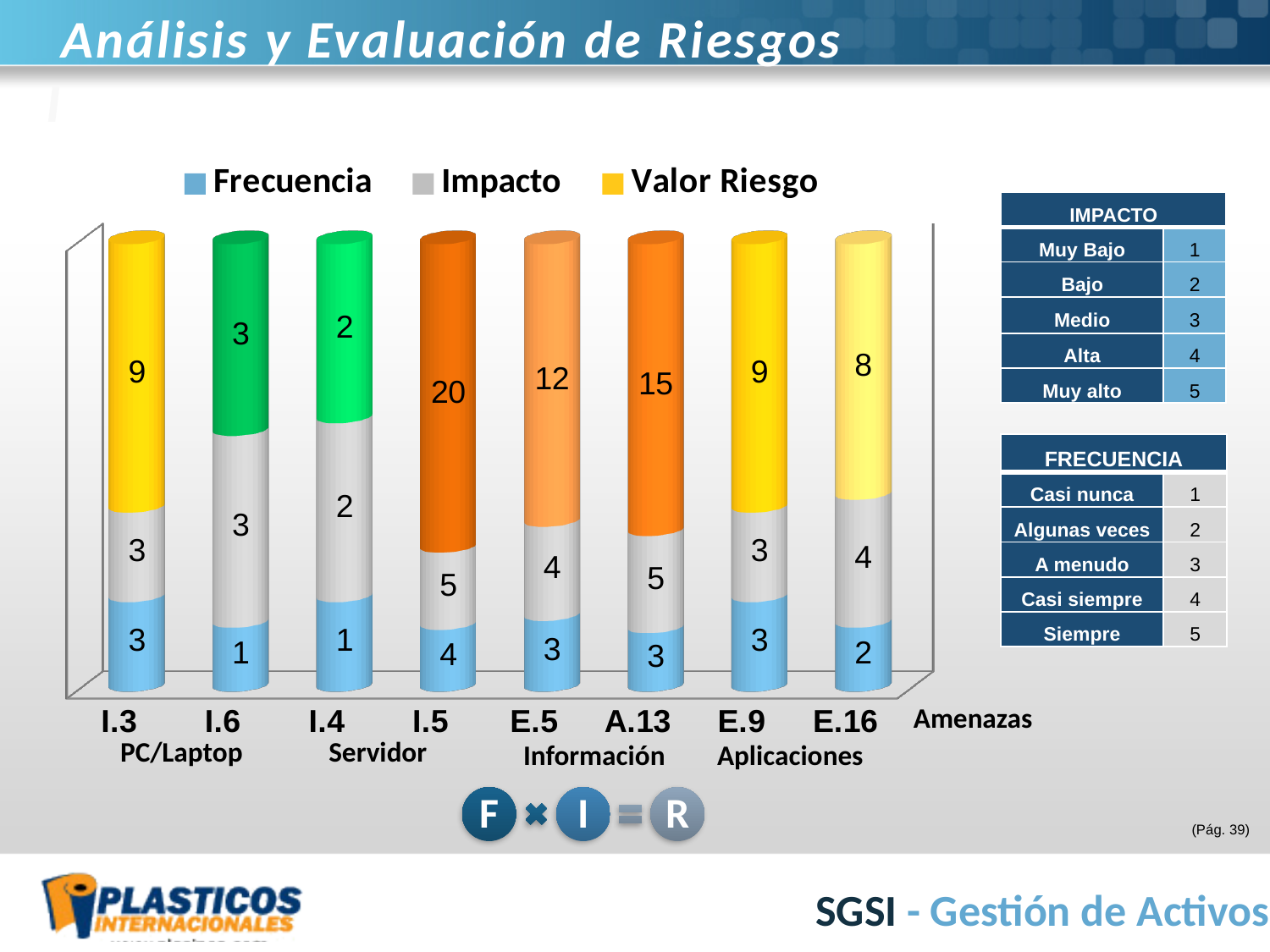
What is the Valor Riesgo value for I.5? 20 What is the difference between the Valor Riesgo values for A.13 and E.5? 3 What is the Impacto value for A.13? 5 How many categories are shown on the x axis of the chart? 8 What is the Frecuencia value for E.16? 2 What kind of chart is shown on the slide? Stacked bar chart Which category has the highest Valor Riesgo value? I.5 What is the total of the stacked bar for I.5 (Frecuencia + Impacto + Valor Riesgo)? 29 Which category has the lowest Valor Riesgo value? I.4 Which has a larger Valor Riesgo value, I.3 or E.16? I.3 Which category has the highest Frecuencia value? I.5 How many series does the chart legend list? 3